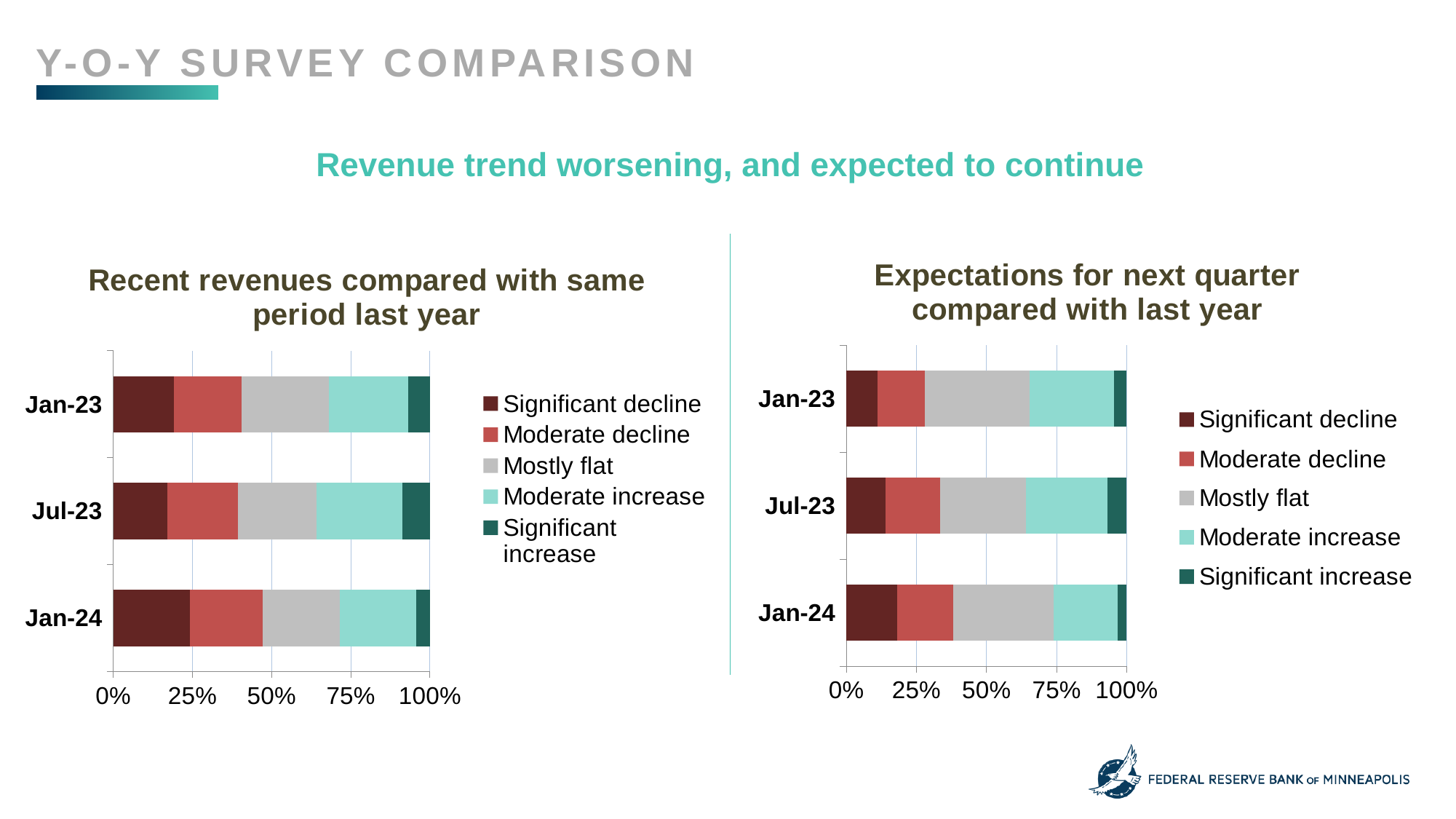
On the 'Recent revenues compared with same period last year' chart, is the 'Significant decline' share for Jan-23 greater or less than 25%? less On the 'Recent revenues compared with same period last year' chart, which survey period has the smallest 'Significant decline' share? Jul-23 What is the highest value shown on the x axis of the 'Recent revenues compared with same period last year' chart? 100% How many survey periods are shown on the 'Expectations for next quarter compared with last year' chart? 3 On the 'Expectations for next quarter compared with last year' chart, which is larger: the 'Significant decline' share for Jan-24 or for Jan-23? Jan-24 On the 'Recent revenues compared with same period last year' chart, which survey period has the largest 'Significant decline' share? Jan-24 On the 'Expectations for next quarter compared with last year' chart, which is larger: the 'Significant increase' share for Jul-23 or for Jan-24? Jul-23 Which legend entry on the 'Expectations for next quarter compared with last year' chart is shown in grey? Mostly flat What is the subtitle shown above the two charts on the slide? Revenue trend worsening, and expected to continue How many series does the legend of the 'Recent revenues compared with same period last year' chart list? 5 What kind of chart is the 'Recent revenues compared with same period last year' chart? Stacked bar chart On the 'Expectations for next quarter compared with last year' chart, is the 'Significant decline' share for Jan-23 greater or less than 25%? less